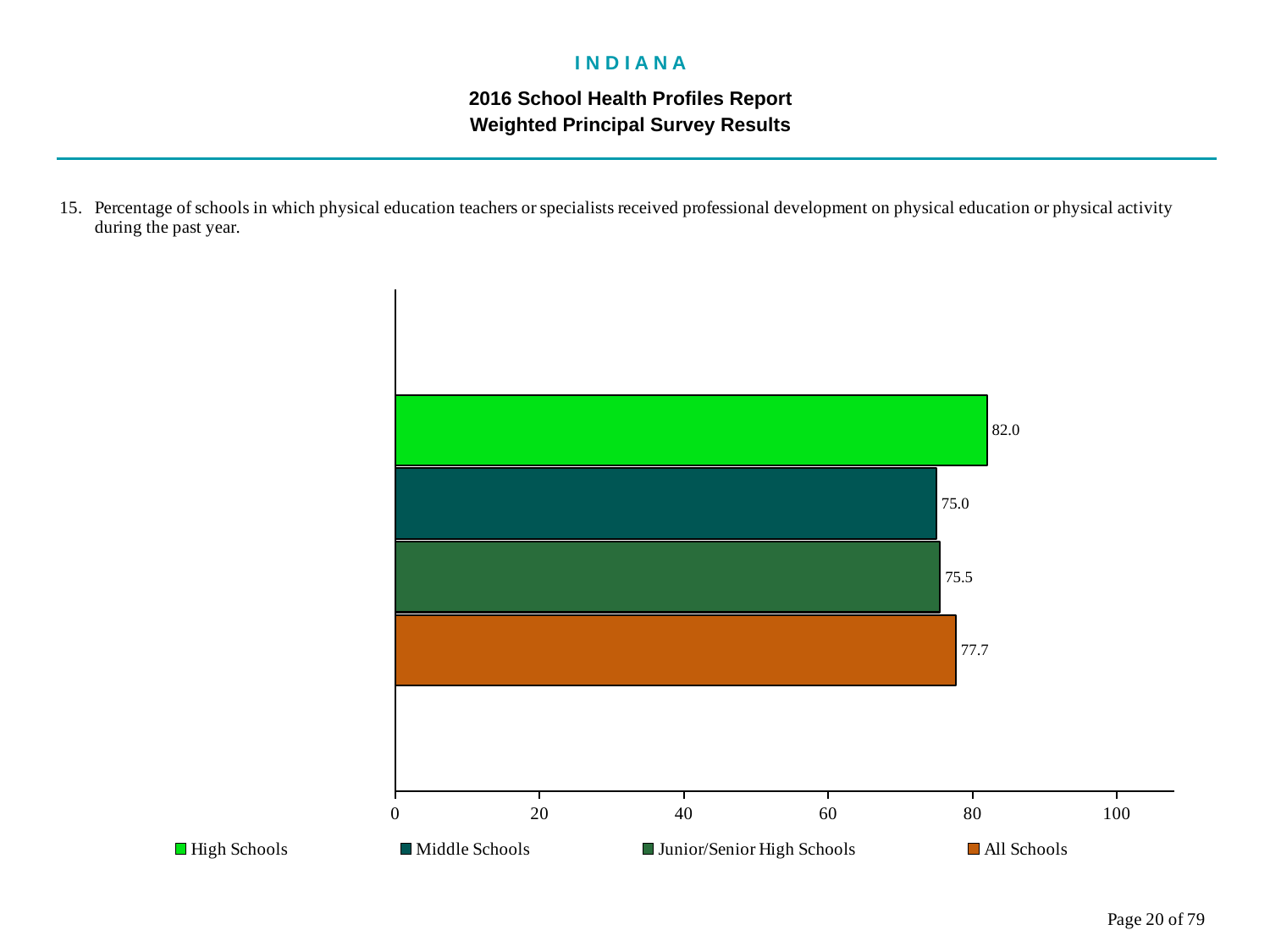
What is the value for High Schools? 82.0 Is the value for High Schools greater or less than 80? greater What is the value for All Schools? 77.7 What is the value for Middle Schools? 75.0 Which is larger, the value for High Schools or the value for All Schools? High Schools What is the value for Junior/Senior High Schools? 75.5 What is the difference between the High Schools value and the Middle Schools value? 7.0 What is the difference between the All Schools value and the Junior/Senior High Schools value? 2.2 What kind of chart is shown on the slide? bar chart How many series does the legend list? 4 Which school type has the lowest value? Middle Schools Which school type has the highest value? High Schools